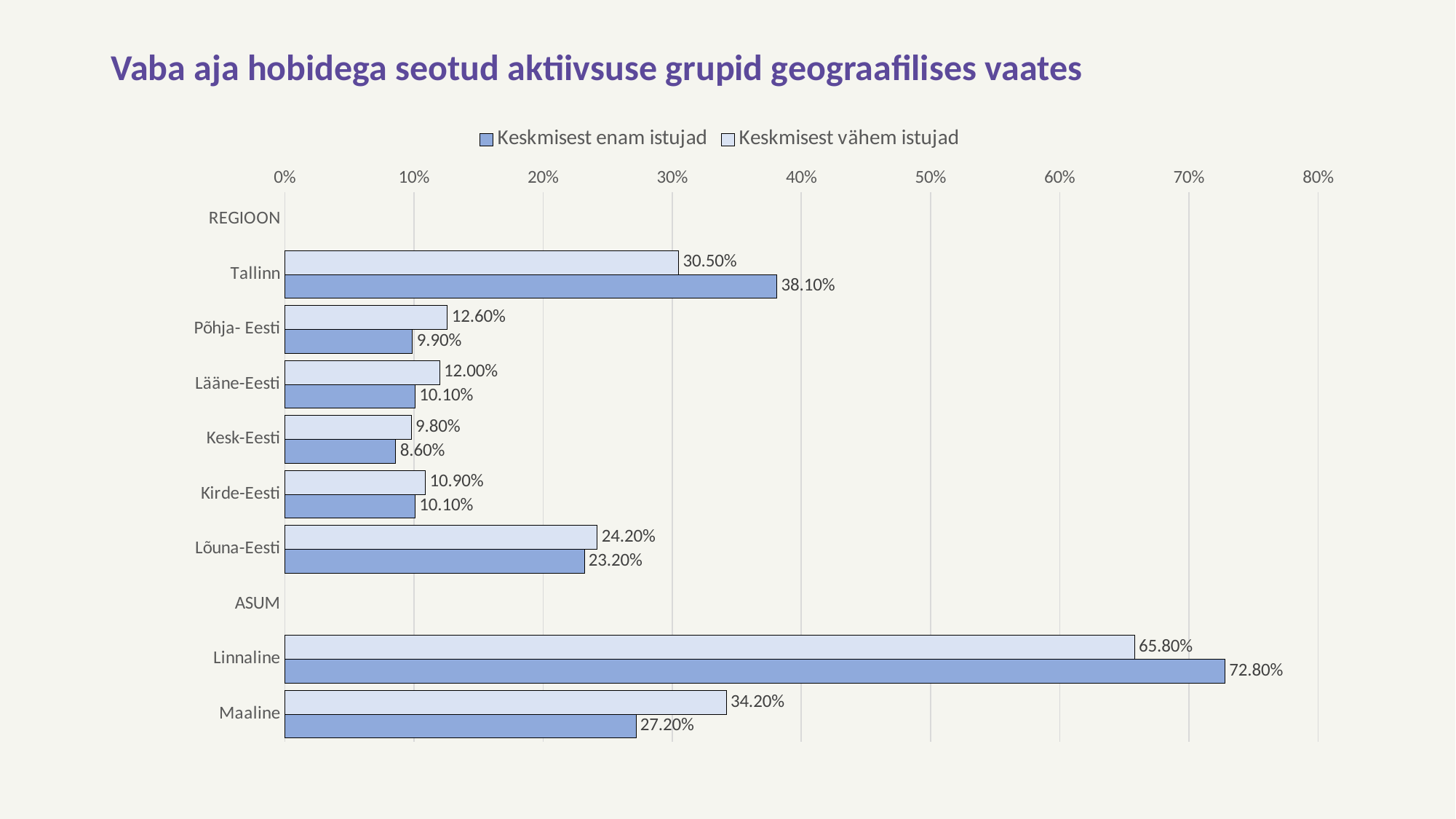
For Põhja-Eesti, which series has the larger value: "Keskmisest enam istujad" or "Keskmisest vähem istujad"? Keskmisest vähem istujad What is the value for Tallinn in the "Keskmisest enam istujad" series? 38.10% What kind of chart is shown on the slide? Bar chart What is the difference between the "Keskmisest vähem istujad" and "Keskmisest enam istujad" values for Tallinn? 7.60% What is the difference between the "Keskmisest enam istujad" and "Keskmisest vähem istujad" values for Linnaline? 7.00% What is the value for Maaline in the "Keskmisest vähem istujad" series? 34.20% How many regions are listed under the REGIOON group? 6 Which category has the highest value in the "Keskmisest enam istujad" series? Linnaline Which category has the lowest value in the "Keskmisest vähem istujad" series? Kesk-Eesti What is the value for Lõuna-Eesti in the "Keskmisest enam istujad" series? 23.20% Is the "Keskmisest enam istujad" value for Linnaline greater or less than 70%? greater How many series does the legend list? 2